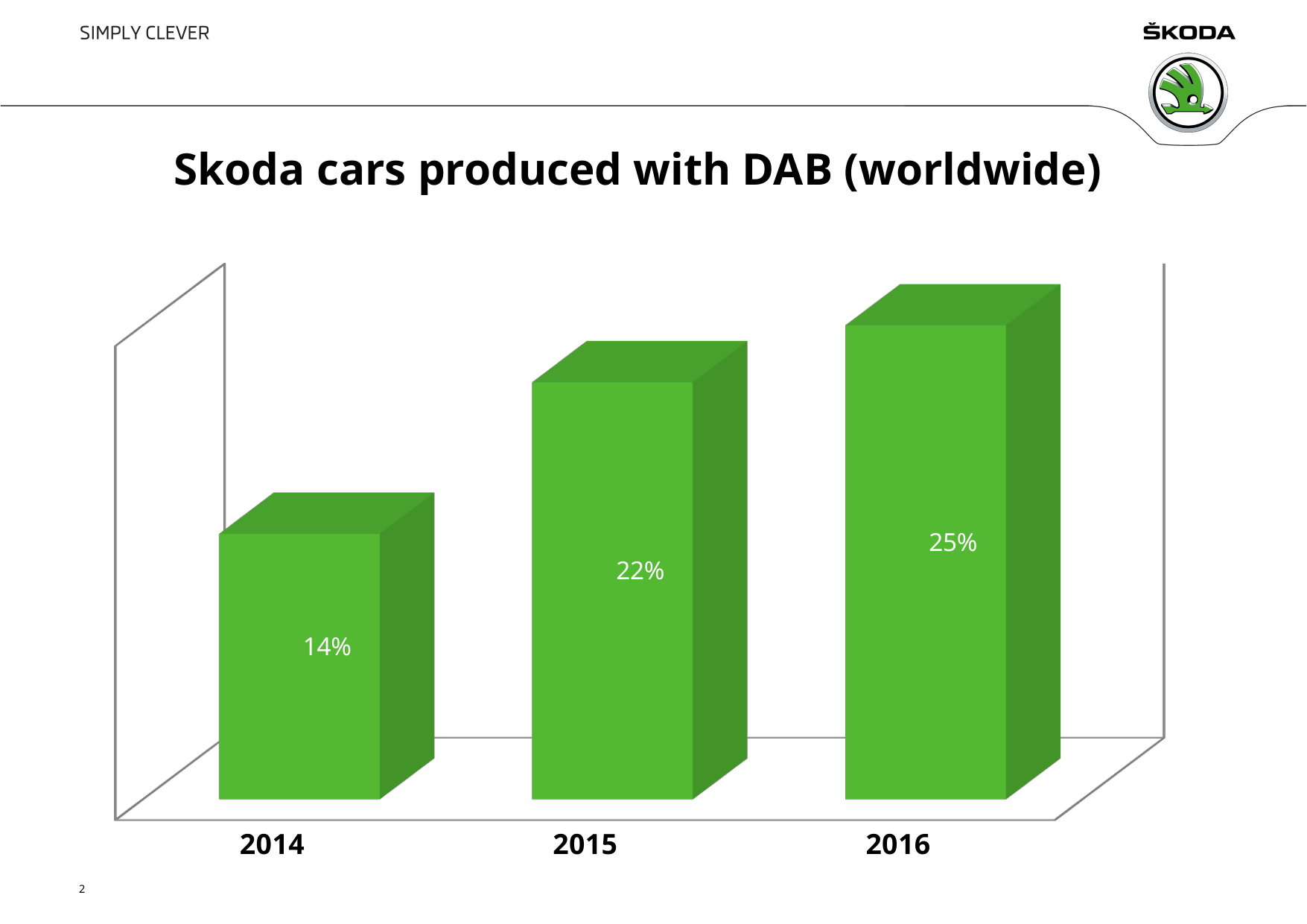
What is the title of the chart? Skoda cars produced with DAB (worldwide) Which year has a larger value, 2015 or 2016? 2016 How many years are shown on the chart? 3 What percentage of Skoda cars were produced with DAB in 2016? 25% What percentage of Skoda cars were produced with DAB in 2014? 14% Do the values rise or fall from 2014 to 2016? Rise What is the difference between the 2016 and 2014 values? 11% What kind of chart is shown on the slide? Bar chart What percentage of Skoda cars were produced with DAB in 2015? 22% Which year has the highest share of Skoda cars produced with DAB? 2016 What is the difference between the 2015 and 2014 values? 8% Which year has the lowest share of Skoda cars produced with DAB? 2014